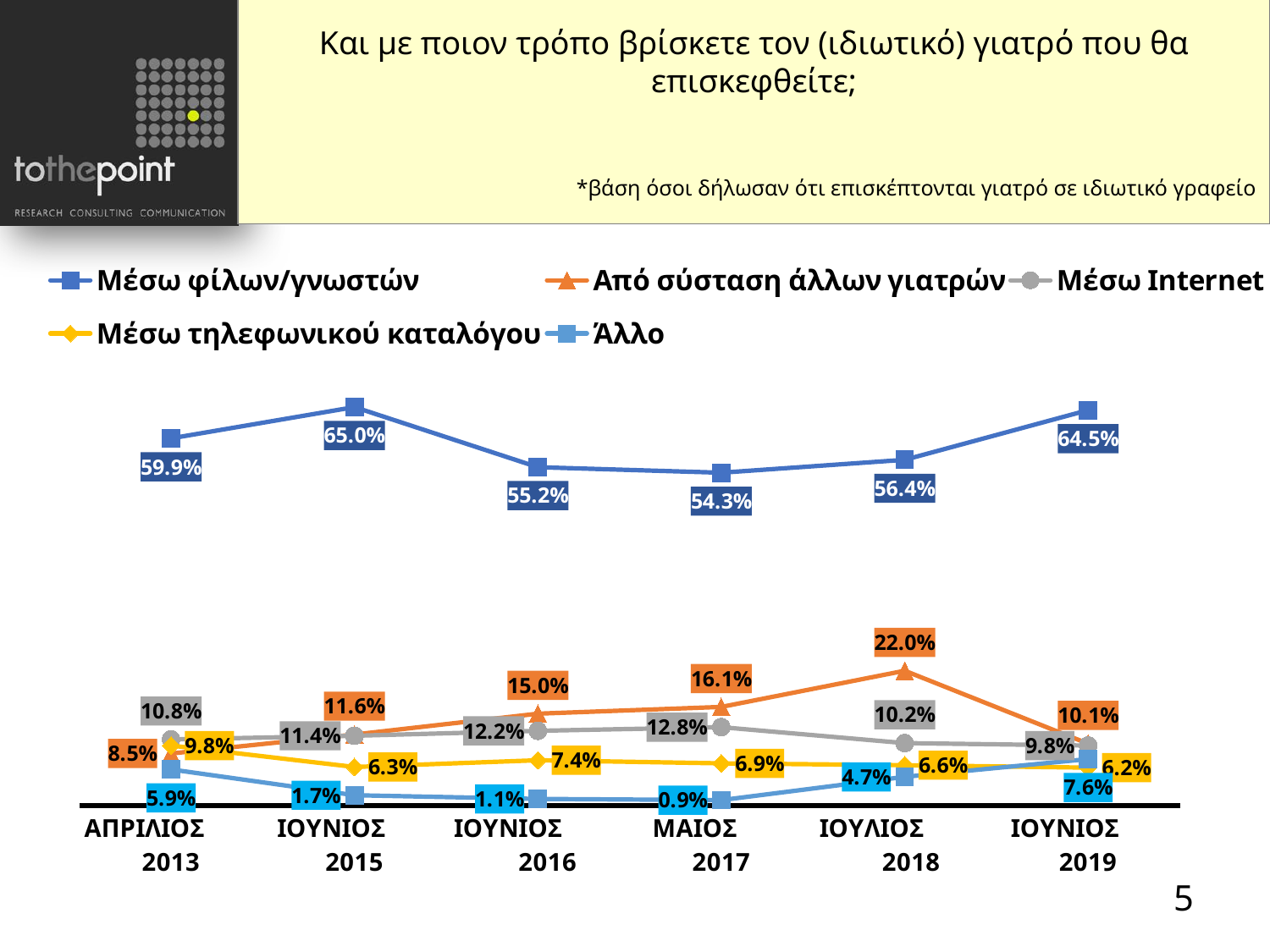
What is the value for Από σύσταση άλλων γιατρών in ΙΟΥΛΙΟΣ 2018? 22.0% What is the value for Μέσω Internet in ΜΑΙΟΣ 2017? 12.8% How many time points are plotted along the x axis? 6 What is the value for Μέσω φίλων/γνωστών in ΙΟΥΝΙΟΣ 2015? 65.0% What is the value for Άλλο in ΙΟΥΝΙΟΣ 2019? 7.6% What type of chart is shown on the slide? line chart How many series does the legend list? 5 Which is larger in ΑΠΡΙΛΙΟΣ 2013: Μέσω Internet or Μέσω τηλεφωνικού καταλόγου? Μέσω Internet What is the difference between the Μέσω φίλων/γνωστών values in ΙΟΥΝΙΟΣ 2015 and ΜΑΙΟΣ 2017? 10.7% In which time point is the value for Από σύσταση άλλων γιατρών highest? ΙΟΥΛΙΟΣ 2018 In which time point is the value for Μέσω φίλων/γνωστών lowest? ΜΑΙΟΣ 2017 Does the value for Άλλο rise or fall from ΑΠΡΙΛΙΟΣ 2013 to ΜΑΙΟΣ 2017? fall